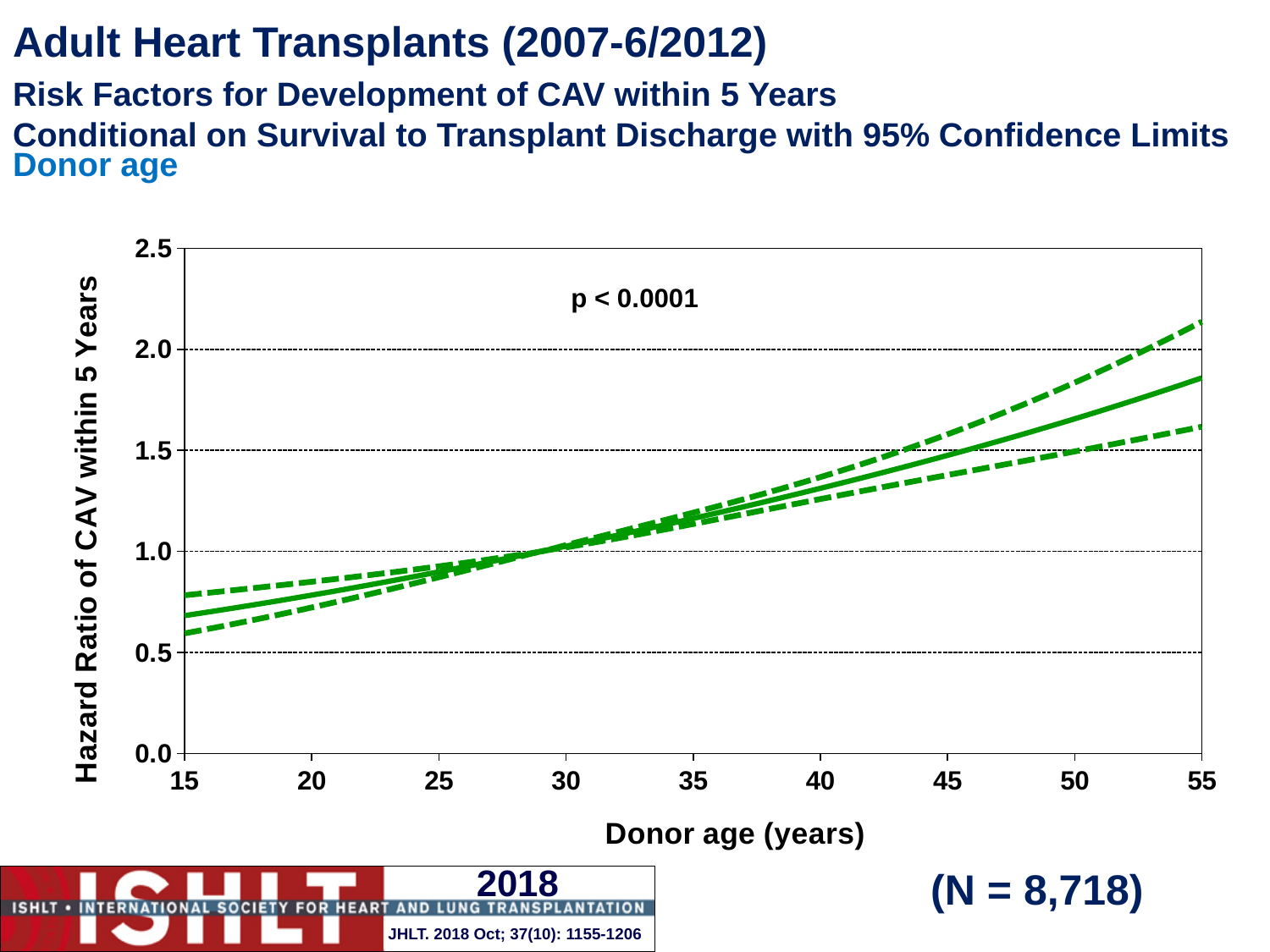
Is the hazard ratio (solid line) at donor age 55 larger or smaller than at donor age 15? larger What kind of chart is shown on the slide? line chart Is the hazard ratio (solid line) at donor age 15 greater or less than 1.0? less What p-value is printed on the chart? p < 0.0001 Is the upper 95% confidence limit (upper dashed line) at donor age 55 greater or less than 2.0? greater What is the sample size (N) shown on the slide? 8,718 At which donor age shown on the x axis is the hazard ratio (solid line) lowest? 15 Does the hazard ratio of CAV within 5 years rise or fall as donor age increases from 15 to 55 years? rise Is the hazard ratio (solid line) at donor age 40 greater or less than 1.0? greater At which donor age shown on the x axis is the hazard ratio (solid line) highest? 55